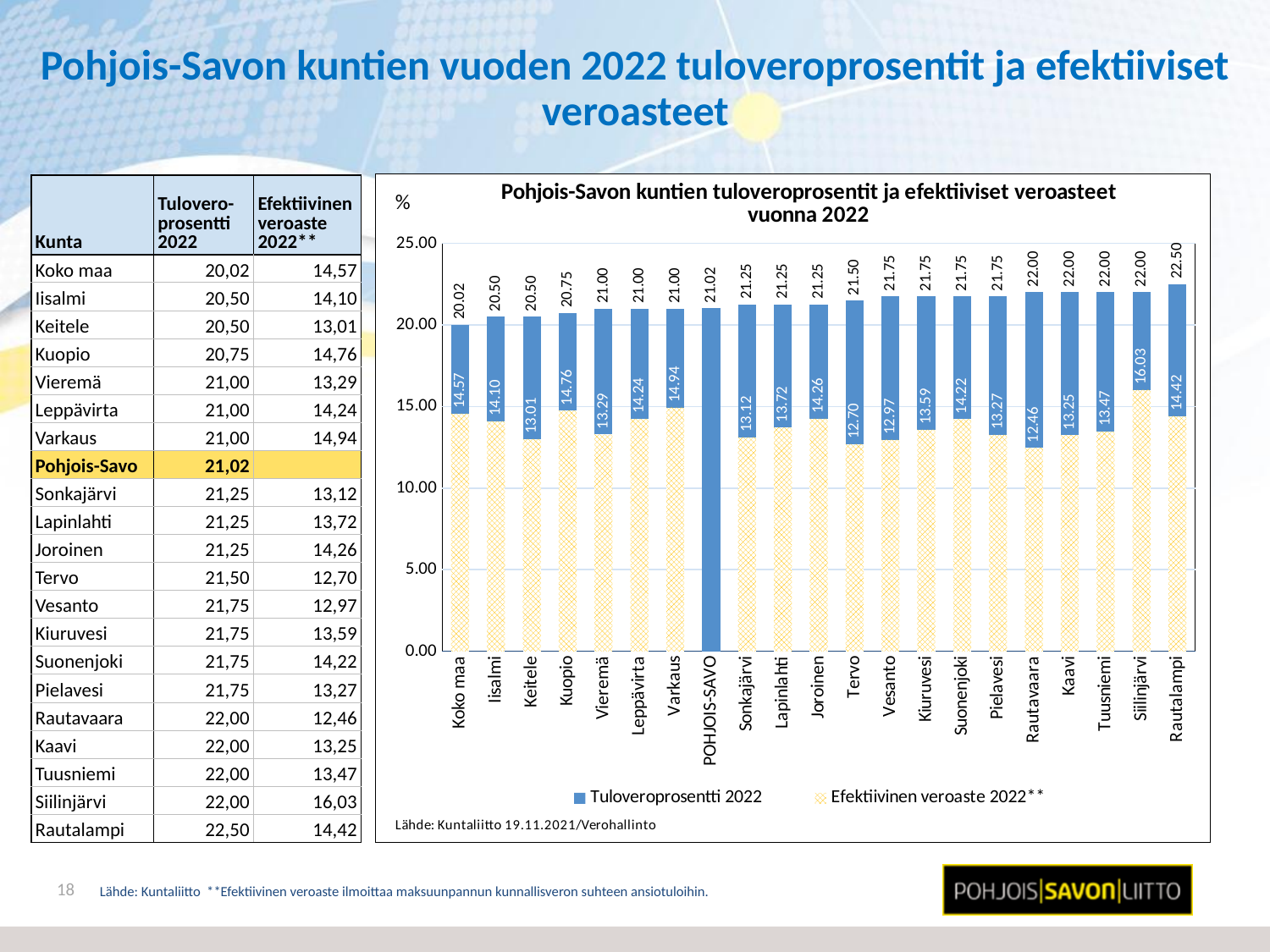
What is the Tuloveroprosentti 2022 value for POHJOIS-SAVO? 21.02 How many categories are shown on the x axis of the chart? 21 How many series does the chart legend list? 2 What is the Tuloveroprosentti 2022 value for Kuopio? 20.75 What is the Efektiivinen veroaste 2022 value for Siilinjärvi? 16.03 Which is larger, the Efektiivinen veroaste 2022 for Varkaus or for Vieremä? Varkaus Is the Efektiivinen veroaste 2022 value for Tervo greater or less than 15.00? less What is the difference between the Tuloveroprosentti 2022 and the Efektiivinen veroaste 2022 for Rautalampi? 8.08 Which category has the highest Efektiivinen veroaste 2022 value? Siilinjärvi Which category has the lowest Efektiivinen veroaste 2022 value? Rautavaara Which category has the highest Tuloveroprosentti 2022 value? Rautalampi What kind of chart is shown on the slide? bar chart